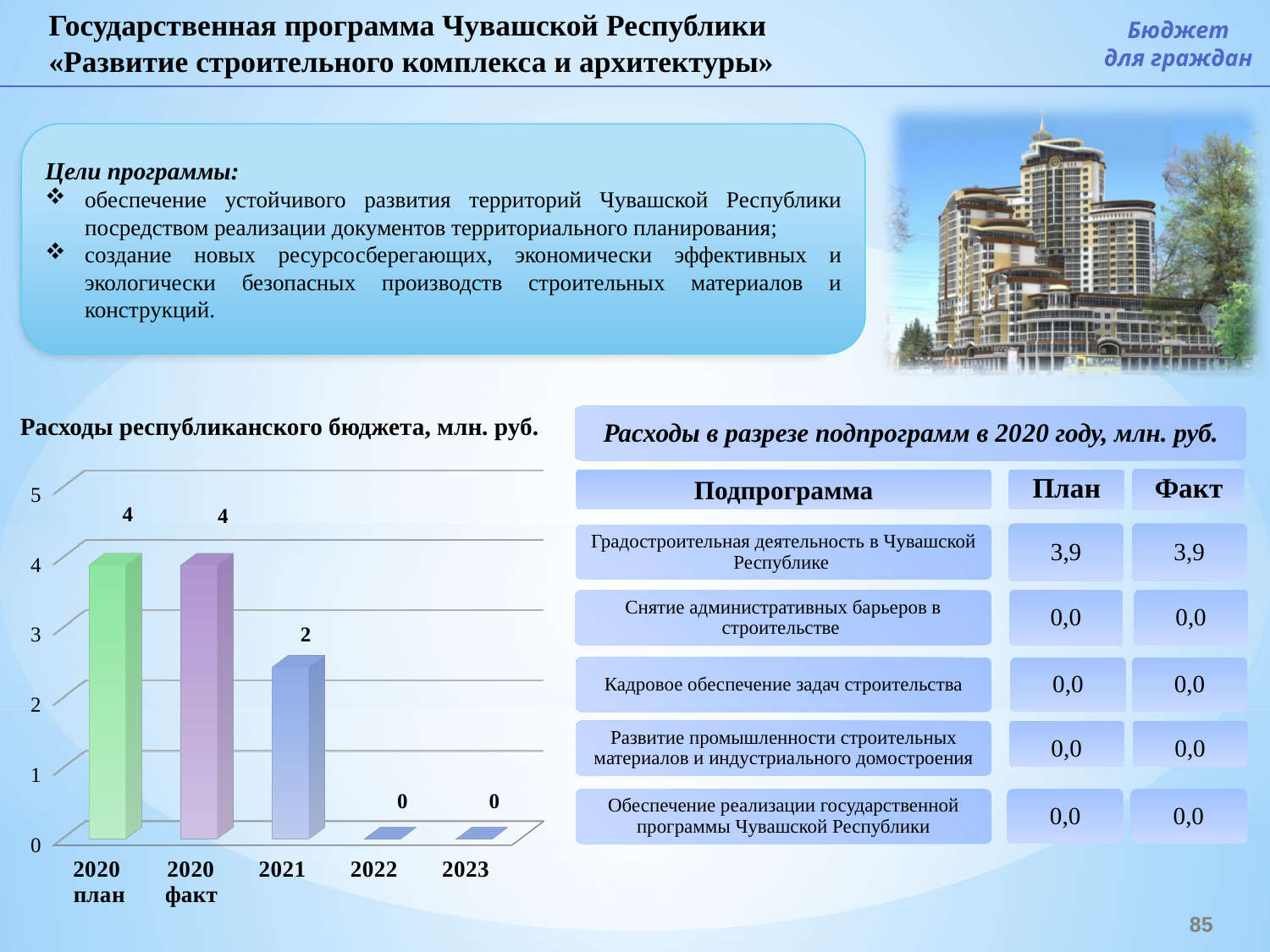
In the chart 'Расходы республиканского бюджета, млн. руб.', is the value for 2021 greater or less than 3? less What is the value for 2023 in the chart 'Расходы республиканского бюджета, млн. руб.'? 0 How many categories are shown on the x axis of the chart 'Расходы республиканского бюджета, млн. руб.'? 5 What kind of chart is 'Расходы республиканского бюджета, млн. руб.'? bar chart In the chart 'Расходы республиканского бюджета, млн. руб.', do the values rise or fall from 2020 факт to 2023? fall What is the title of the chart on the left side of the slide? Расходы республиканского бюджета, млн. руб. In the chart 'Расходы республиканского бюджета, млн. руб.', which is larger: the value for 2021 or the value for 2022? 2021 What is the value for 2022 in the chart 'Расходы республиканского бюджета, млн. руб.'? 0 In the chart 'Расходы республиканского бюджета, млн. руб.', what is the difference between the values for 2020 факт and 2021? 2 What is the value for 2021 in the chart 'Расходы республиканского бюджета, млн. руб.'? 2 What is the value for 2020 факт in the chart 'Расходы республиканского бюджета, млн. руб.'? 4 What is the value for 2020 план in the chart 'Расходы республиканского бюджета, млн. руб.'? 4